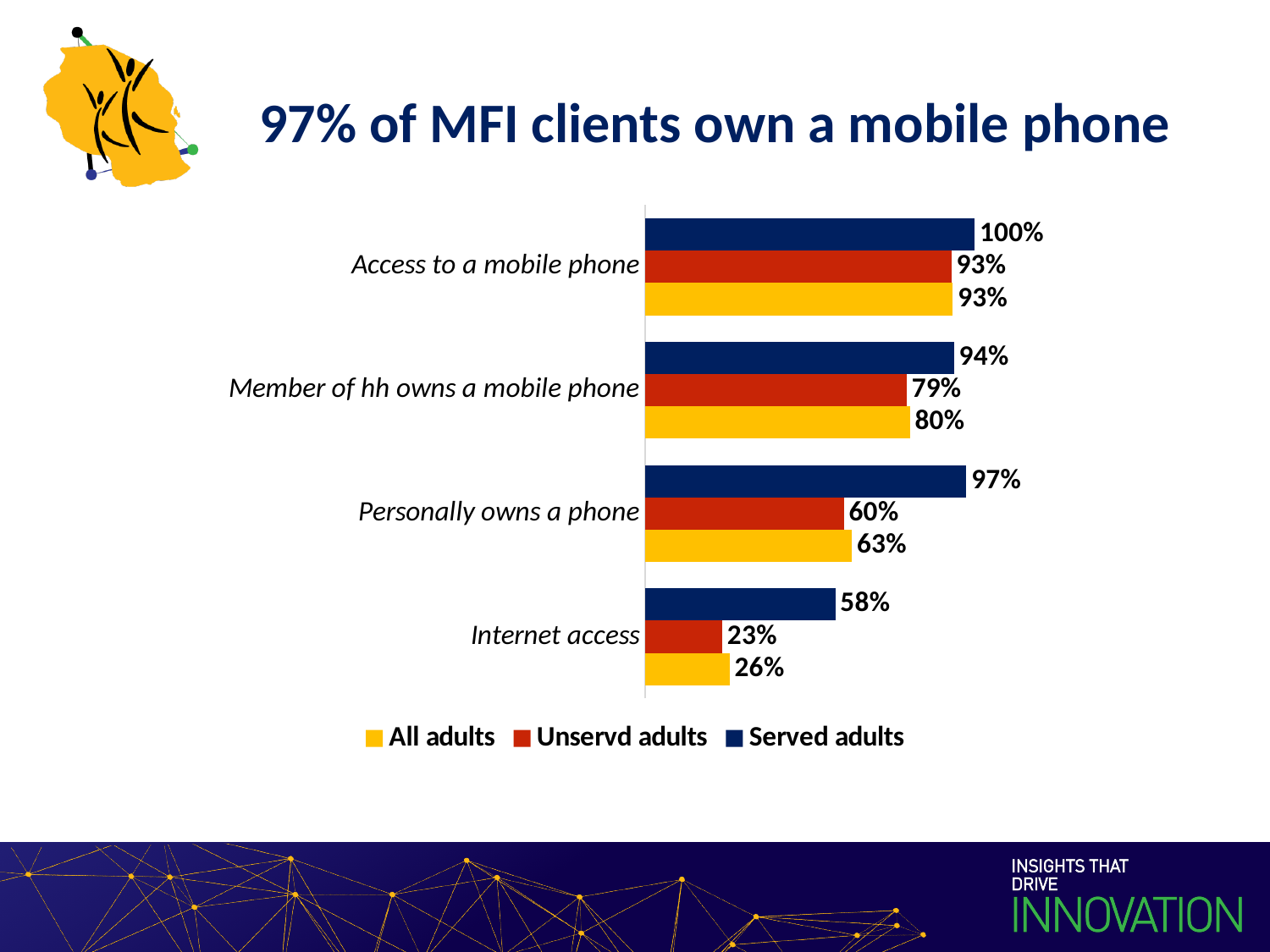
Which colour represents Served adults in the chart? Dark blue Which is larger for Member of hh owns a mobile phone: Served adults or Unservd adults? Served adults Which category has the lowest value for All adults? Internet access What is the value for All adults for Member of hh owns a mobile phone? 80% What is the difference between Served adults and Unservd adults for Internet access? 35% How many series does the legend list? 3 What is the difference between Served adults and All adults for Personally owns a phone? 34% Which category has the highest value for Served adults? Access to a mobile phone What is the value for Served adults for Internet access? 58% What is the value for Unservd adults for Personally owns a phone? 60% How many categories are shown on the chart? 4 What kind of chart is shown on the slide? Bar chart